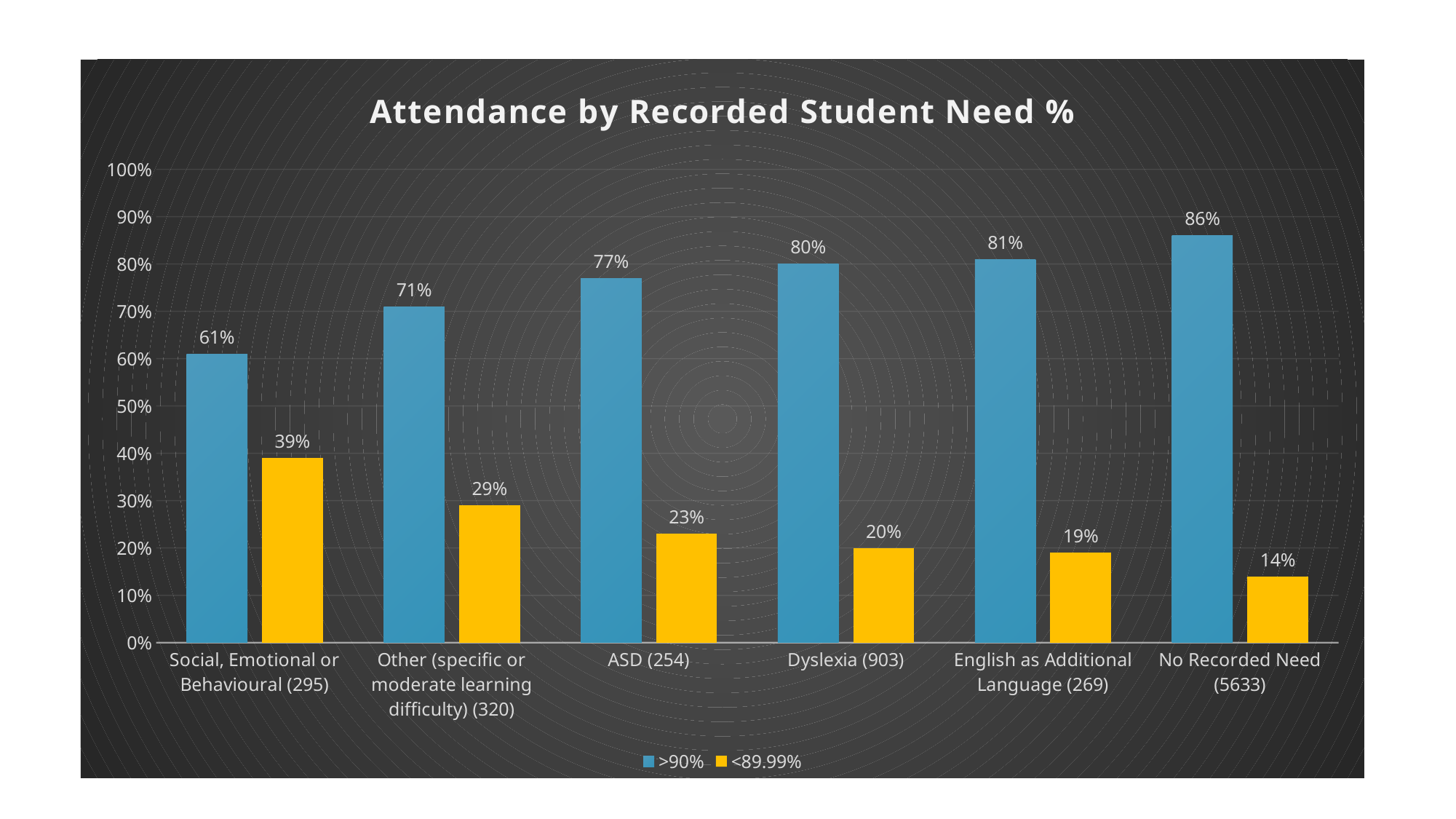
Which category has the lowest <89.99% value? No Recorded Need (5633) Which category has the highest >90% attendance value? No Recorded Need (5633) Which is larger: the >90% value for English as Additional Language (269) or for Dyslexia (903)? English as Additional Language (269) How many series does the legend list? 2 What kind of chart is shown? Bar chart How many categories are shown on the x axis? 6 What is the >90% attendance value for Dyslexia (903)? 80% What is the title of the chart? Attendance by Recorded Student Need % What is the difference between the >90% values for No Recorded Need (5633) and Social, Emotional or Behavioural (295)? 25% Which colour represents the <89.99% series? Yellow What is the <89.99% attendance value for Social, Emotional or Behavioural (295)? 39% What is the >90% value for ASD (254)? 77%